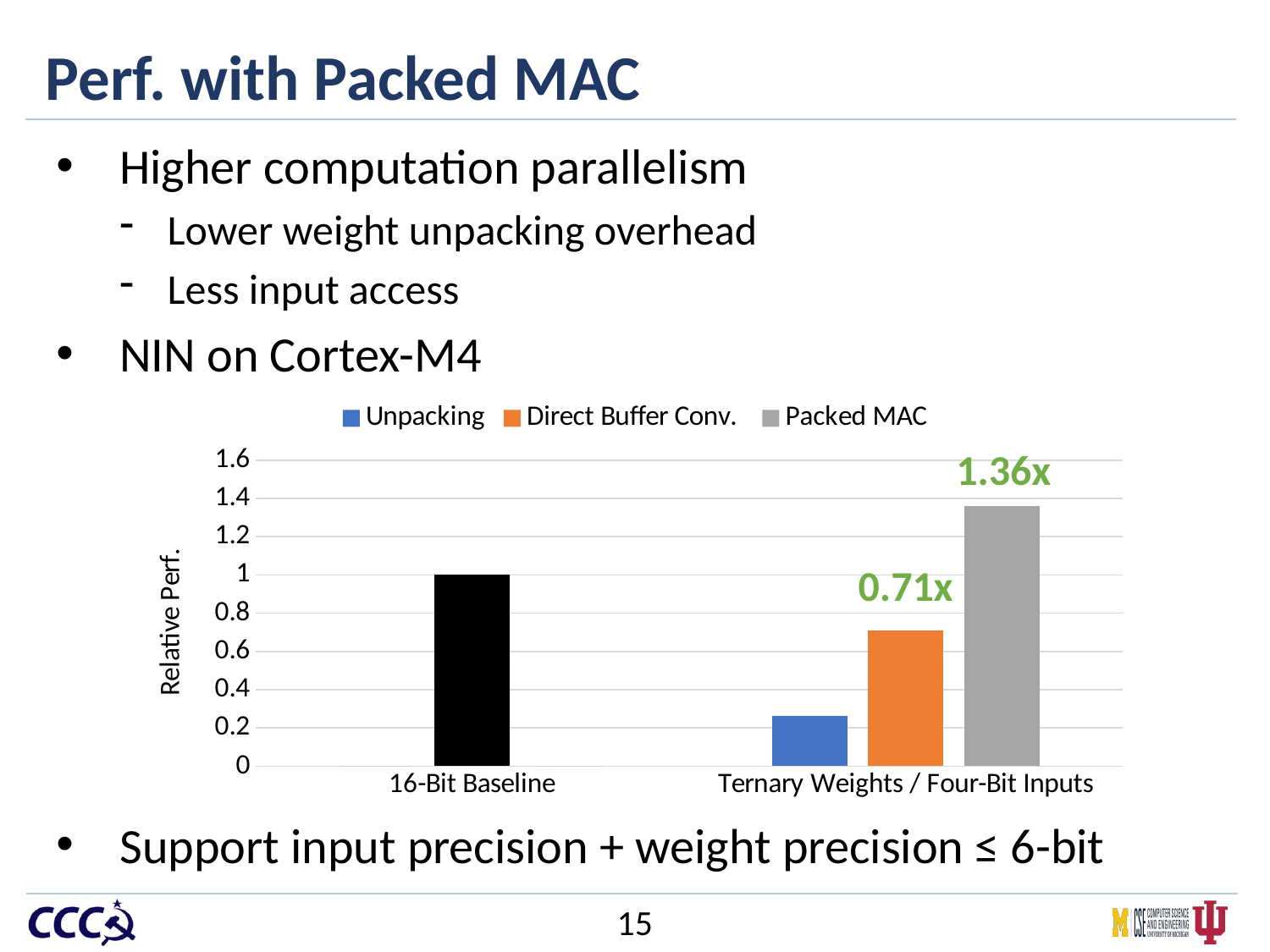
Is the value for Unpacking under Ternary Weights / Four-Bit Inputs greater or less than 0.4? less How many categories are shown on the x axis of the chart? 2 Which is larger: the Packed MAC bar or the 16-Bit Baseline bar? Packed MAC What kind of chart is shown on the slide? bar chart How many series does the chart legend list? 3 What is the relative performance labelled for Packed MAC under Ternary Weights / Four-Bit Inputs? 1.36x Which series has the highest bar in the Ternary Weights / Four-Bit Inputs category? Packed MAC What is the relative performance labelled for Direct Buffer Conv. under Ternary Weights / Four-Bit Inputs? 0.71x What is the difference between the Packed MAC value (1.36x) and the Direct Buffer Conv. value (0.71x)? 0.65x What is the label on the y axis of the chart? Relative Perf. What is the relative performance of the 16-Bit Baseline bar? 1 Which series has the lowest bar in the Ternary Weights / Four-Bit Inputs category? Unpacking